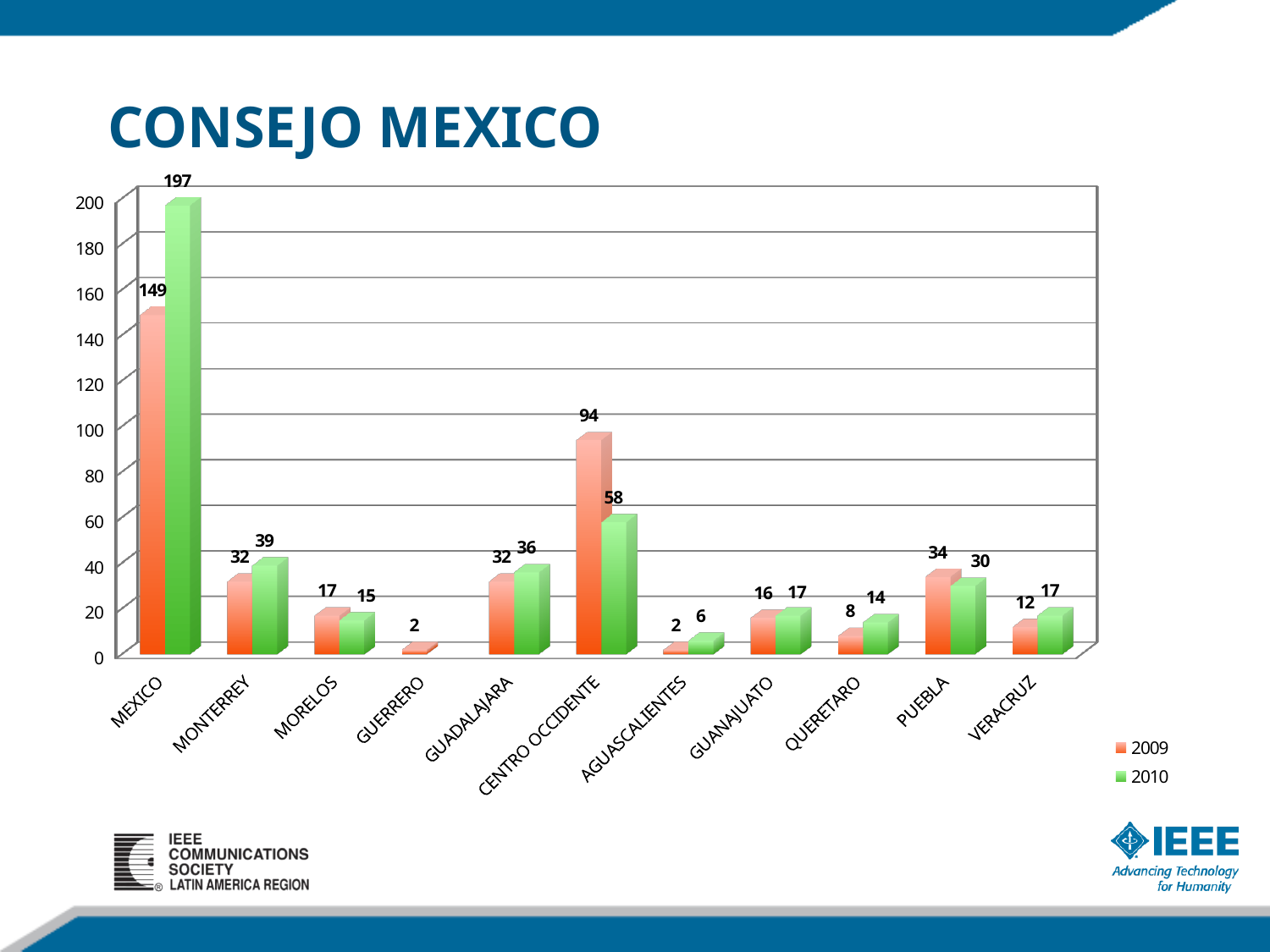
What is the difference between the 2010 and 2009 values for MEXICO? 48 Which category has the highest 2009 value? MEXICO What is the title of the chart? CONSEJO MEXICO What is the 2010 value for QUERETARO? 14 What kind of chart is shown on the slide? bar chart Which is larger for PUEBLA, the 2009 value or the 2010 value? 2009 What is the 2009 value for CENTRO OCCIDENTE? 94 What is the difference between the 2009 and 2010 values for CENTRO OCCIDENTE? 36 How many series does the legend list? 2 Which category has the lowest 2010 value among those with a 2010 bar? AGUASCALIENTES What is the 2010 value for MEXICO? 197 How many categories are shown on the x axis? 11